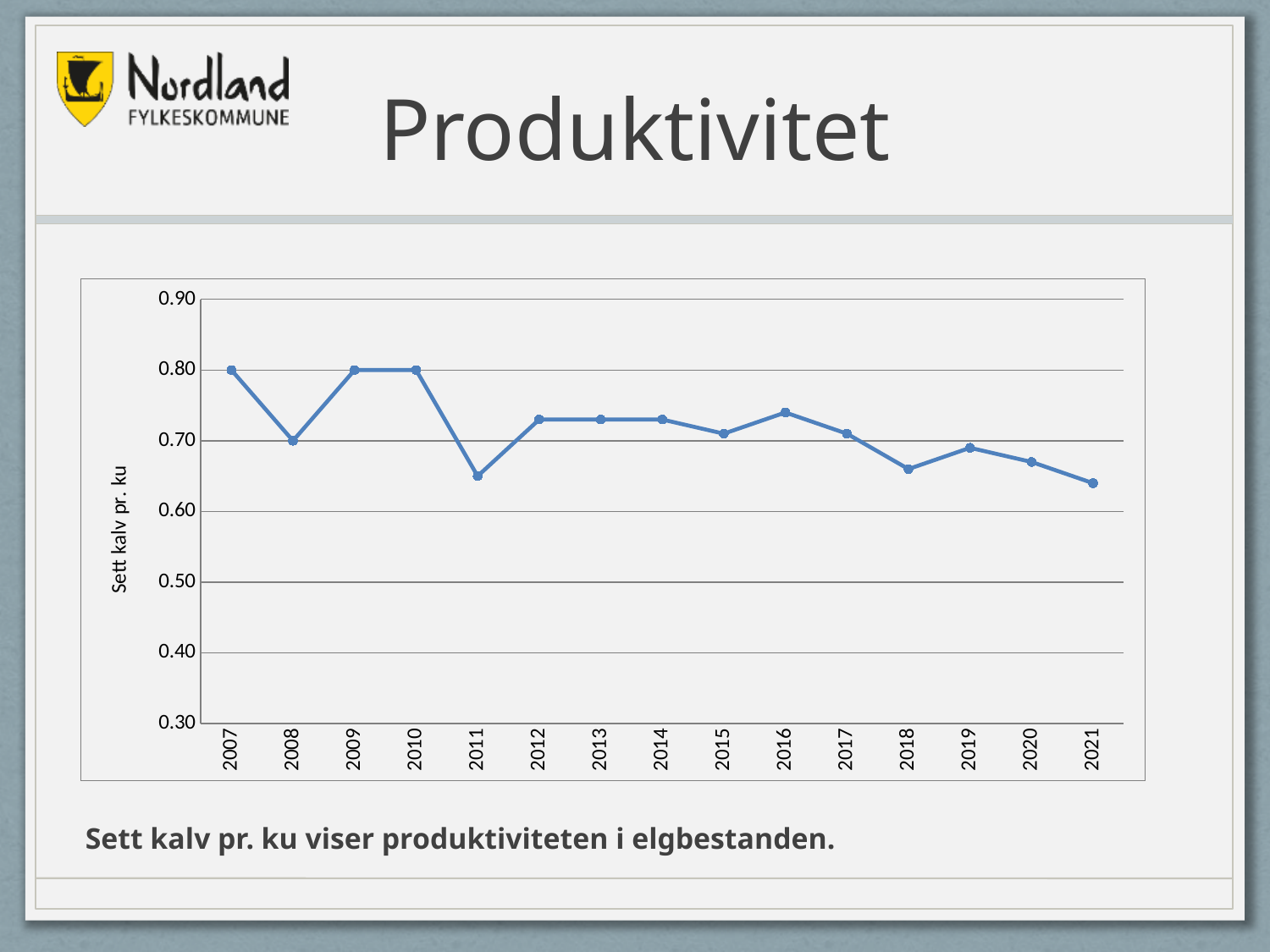
Is the value for 2016 greater or less than 0.70? greater What is the value for 2007? 0.80 What is the difference between the values for 2007 and 2008? 0.10 Which year has the larger value, 2016 or 2018? 2016 Is the value for 2021 greater or less than 0.70? less What is the value for 2010? 0.80 How many years are plotted on the x axis? 15 What is the value for 2008? 0.70 What type of chart is shown on the slide? line chart Is the value for 2011 greater or less than 0.70? less Do the values generally rise or fall from 2007 to 2021? fall What is the label on the y axis? Sett kalv pr. ku